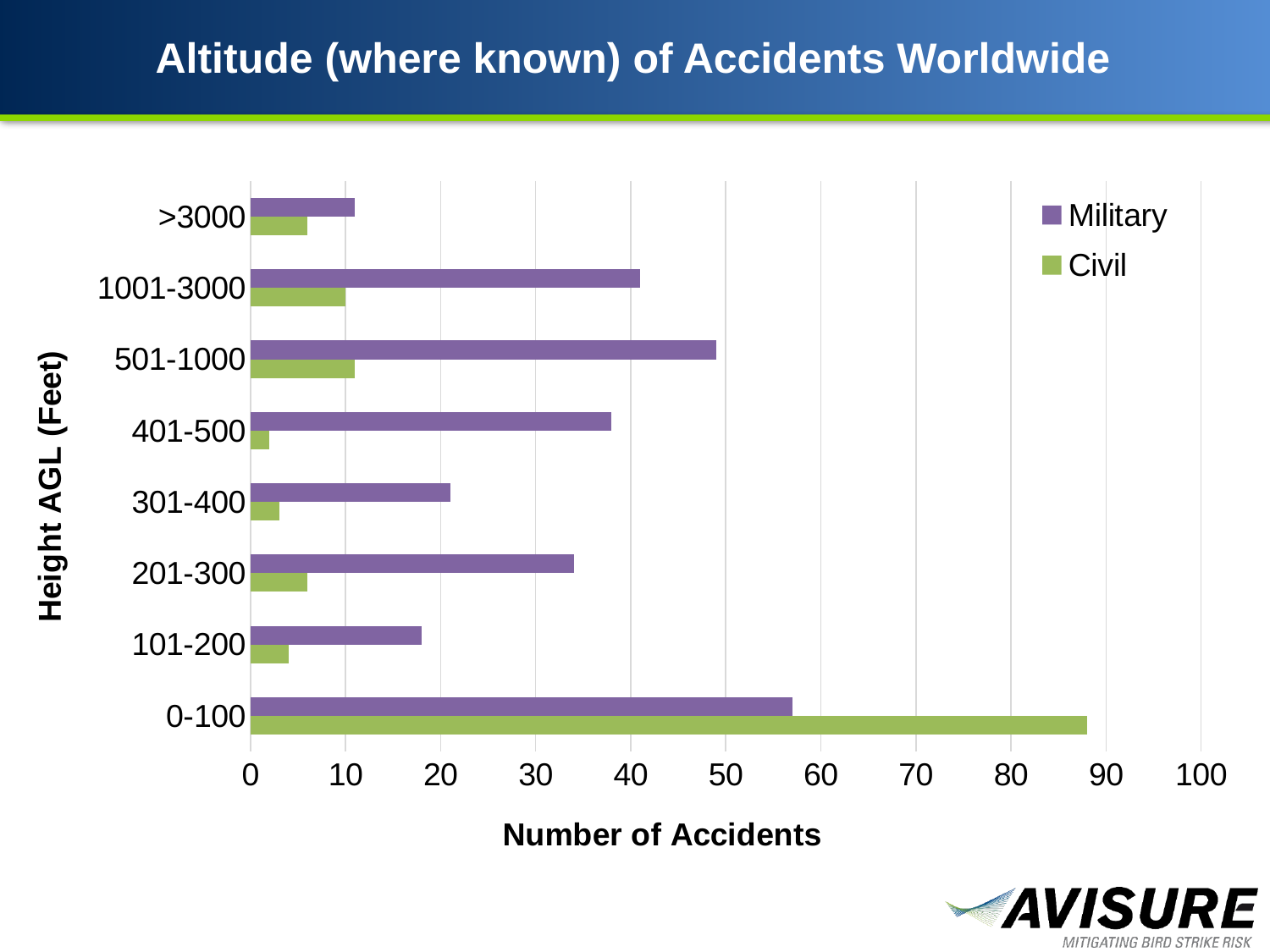
Is the number of Civil accidents for 0-100 feet greater or less than 80? greater What kind of chart is shown on the slide? bar chart How many series does the legend list? 2 Which height category has the lowest number of Military accidents? >3000 For the 0-100 feet category, which series has more accidents, Military or Civil? Civil Is the number of Military accidents for 201-300 feet greater or less than 30? greater How many height categories are shown on the vertical axis? 8 Is the number of Military accidents for 0-100 feet greater or less than 50? greater For the 501-1000 feet category, which series has more accidents, Military or Civil? Military Which height category has the highest number of Military accidents? 0-100 Which height category has the highest number of Civil accidents? 0-100